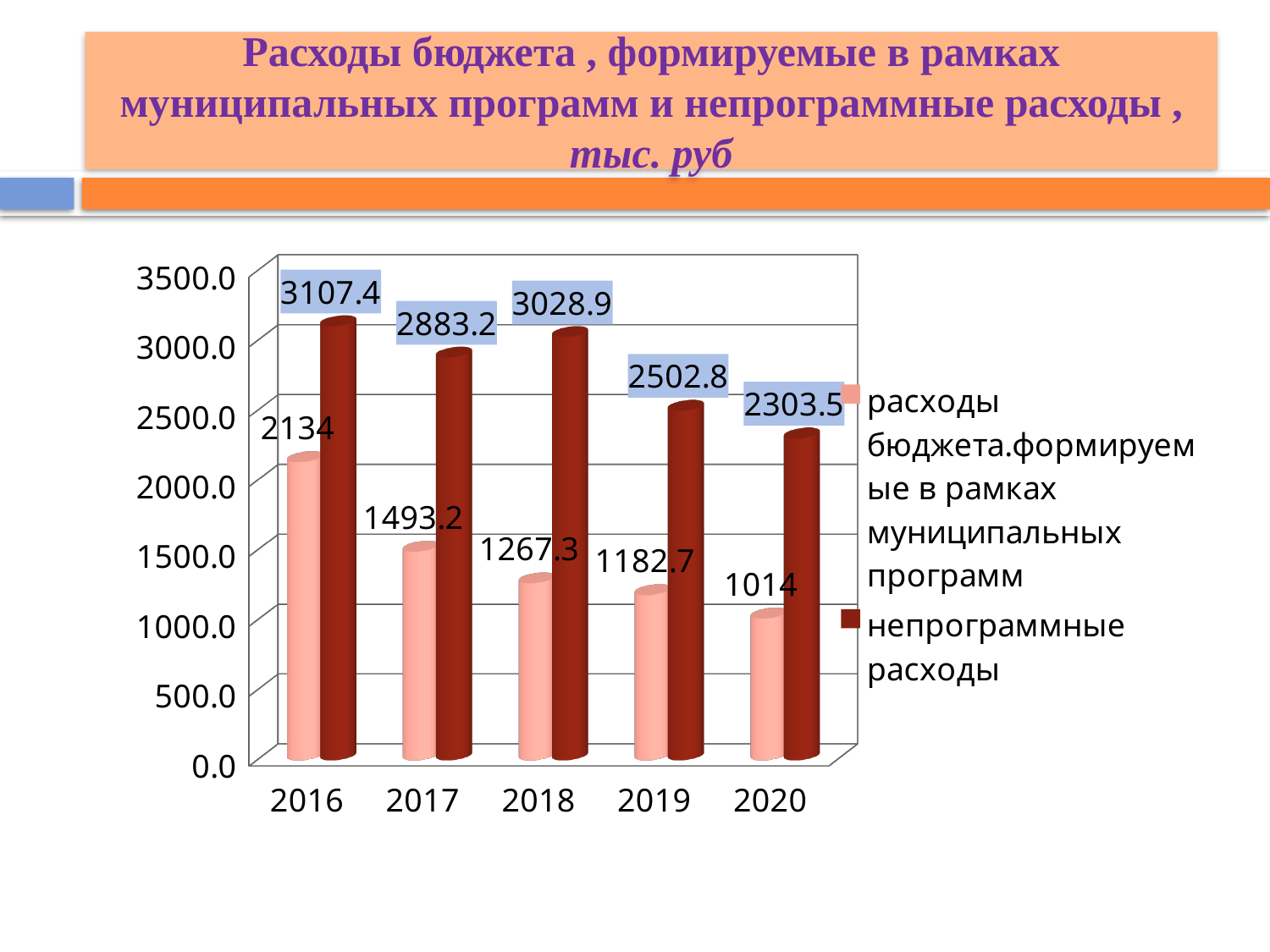
What is the difference between непрограммные расходы and расходы бюджета, формируемые в рамках муниципальных программ in 2018? 1761.6 In which year is the value of расходы бюджета, формируемые в рамках муниципальных программ the highest? 2016 What is the value of непрограммные расходы for 2019? 2502.8 In which year is the value of непрограммные расходы the lowest? 2020 Is the value of непрограммные расходы for 2020 greater or less than 2000.0? greater How many series does the legend list? 2 What kind of chart is shown on the slide? bar chart What is the value of непрограммные расходы for 2016? 3107.4 How many years are shown on the x axis? 5 Do the values of расходы бюджета, формируемые в рамках муниципальных программ rise or fall from 2016 to 2020? fall What is the value of расходы бюджета, формируемые в рамках муниципальных программ for 2020? 1014 Which is larger in 2017: непрограммные расходы or расходы бюджета, формируемые в рамках муниципальных программ? непрограммные расходы